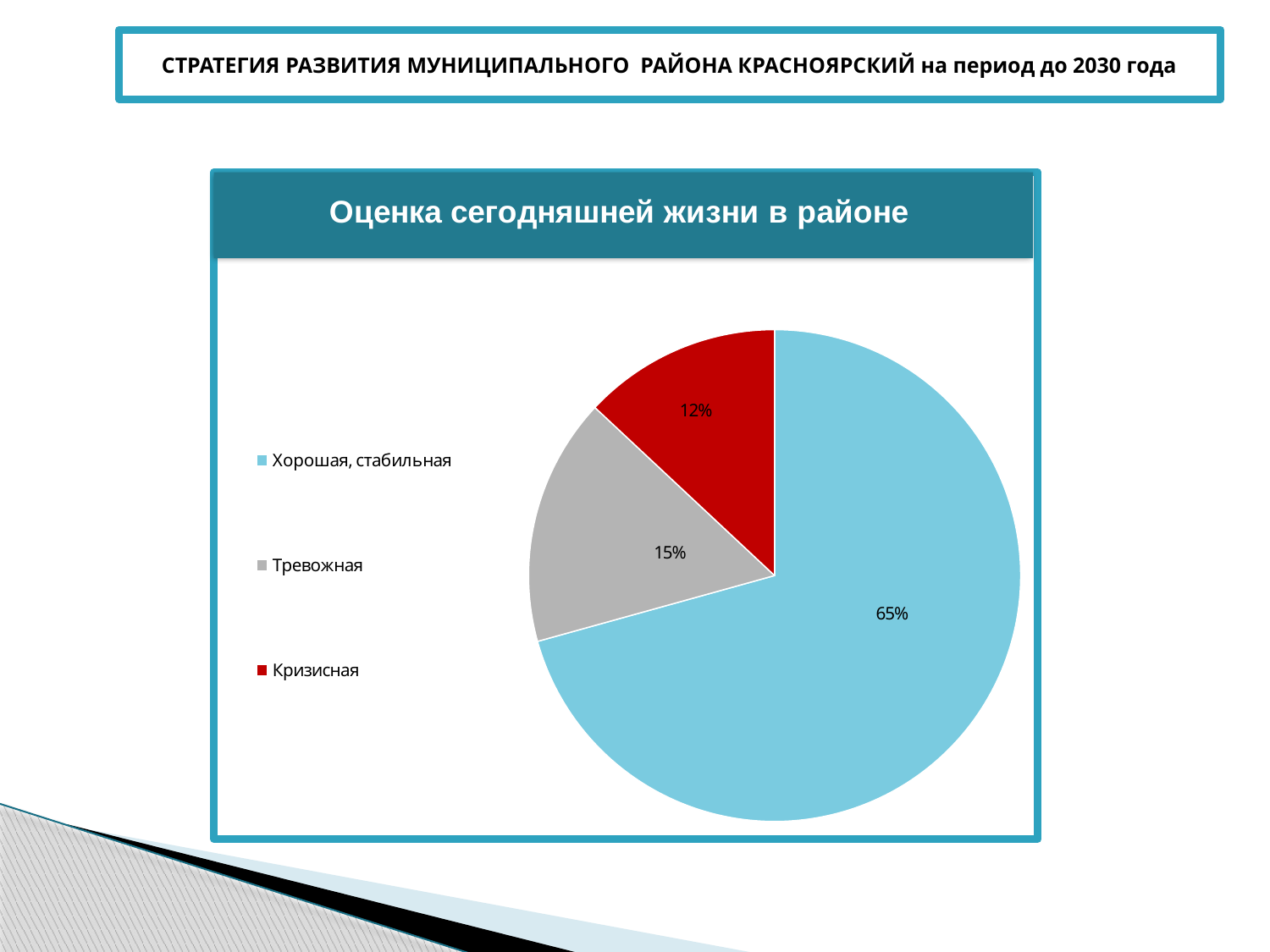
Which category has the largest slice of the pie? Хорошая, стабильная How many categories does the pie chart show? 3 What colour is the slice for "Кризисная"? red What kind of chart is shown on the slide? pie chart What is the title of the chart? Оценка сегодняшней жизни в районе What share of the pie is labelled "Кризисная"? 12% Which is larger, the share for "Тревожная" or the share for "Кризисная"? Тревожная Which category has the smallest slice of the pie? Кризисная What share of the pie is labelled "Хорошая, стабильная"? 65% What share of the pie is labelled "Тревожная"? 15% What is the difference between the shares for "Хорошая, стабильная" and "Тревожная"? 50% What is the difference between the shares for "Тревожная" and "Кризисная"? 3%